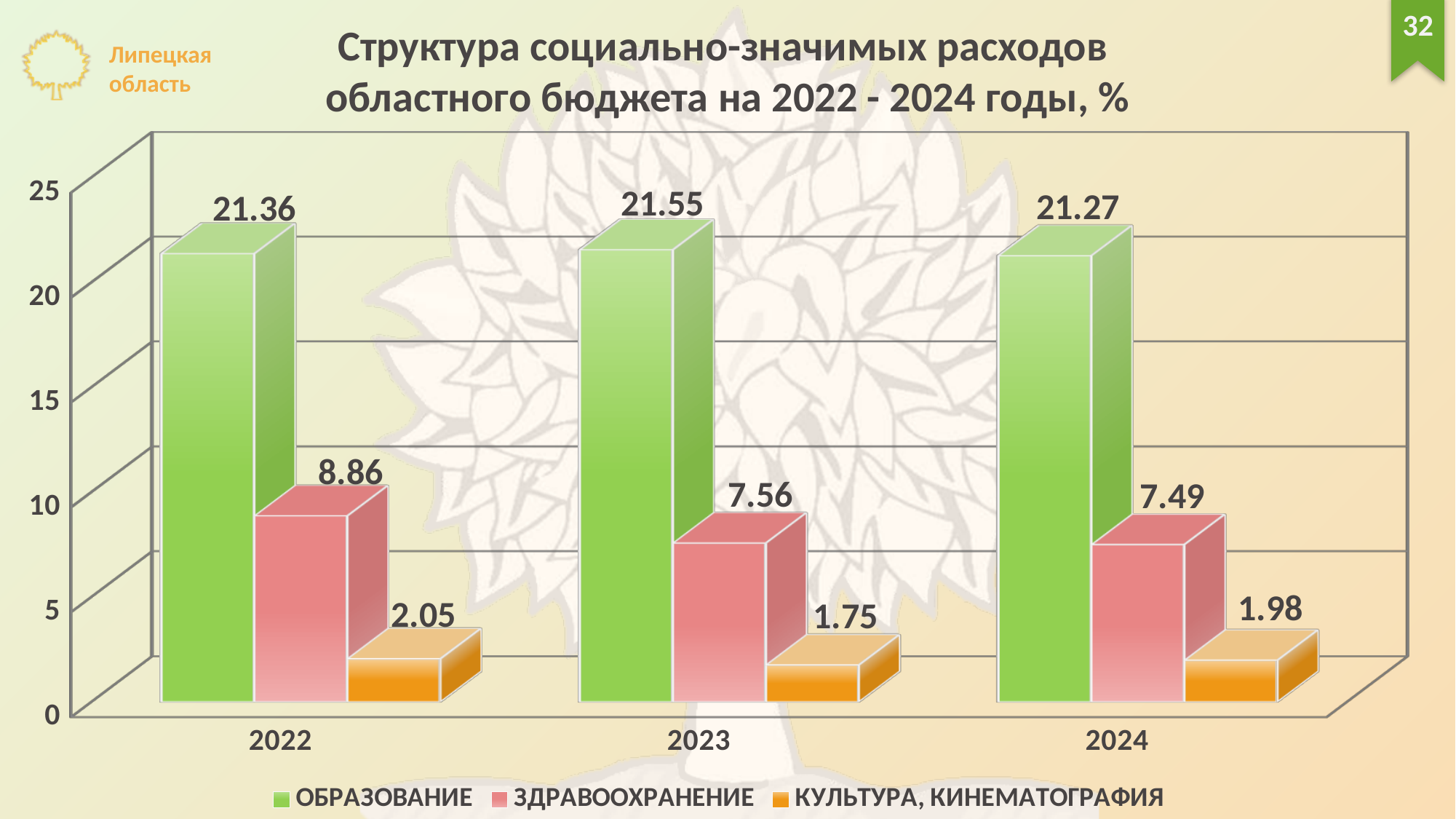
Is the value for ЗДРАВООХРАНЕНИЕ in 2022 greater or less than 10? less What kind of chart is shown on the slide? bar chart What is the value for КУЛЬТУРА, КИНЕМАТОГРАФИЯ in 2024? 1.98 How many series does the legend list? 3 What is the value for ЗДРАВООХРАНЕНИЕ in 2023? 7.56 What is the value for ОБРАЗОВАНИЕ in 2022? 21.36 Which colour represents ОБРАЗОВАНИЕ in the legend? green What is the difference between the ЗДРАВООХРАНЕНИЕ values for 2022 and 2023? 1.3 Which is larger: the ЗДРАВООХРАНЕНИЕ value in 2024 or in 2022? 2022 In which year is the value for КУЛЬТУРА, КИНЕМАТОГРАФИЯ the lowest? 2023 In which year is the value for ОБРАЗОВАНИЕ the highest? 2023 How many years are shown on the x axis? 3